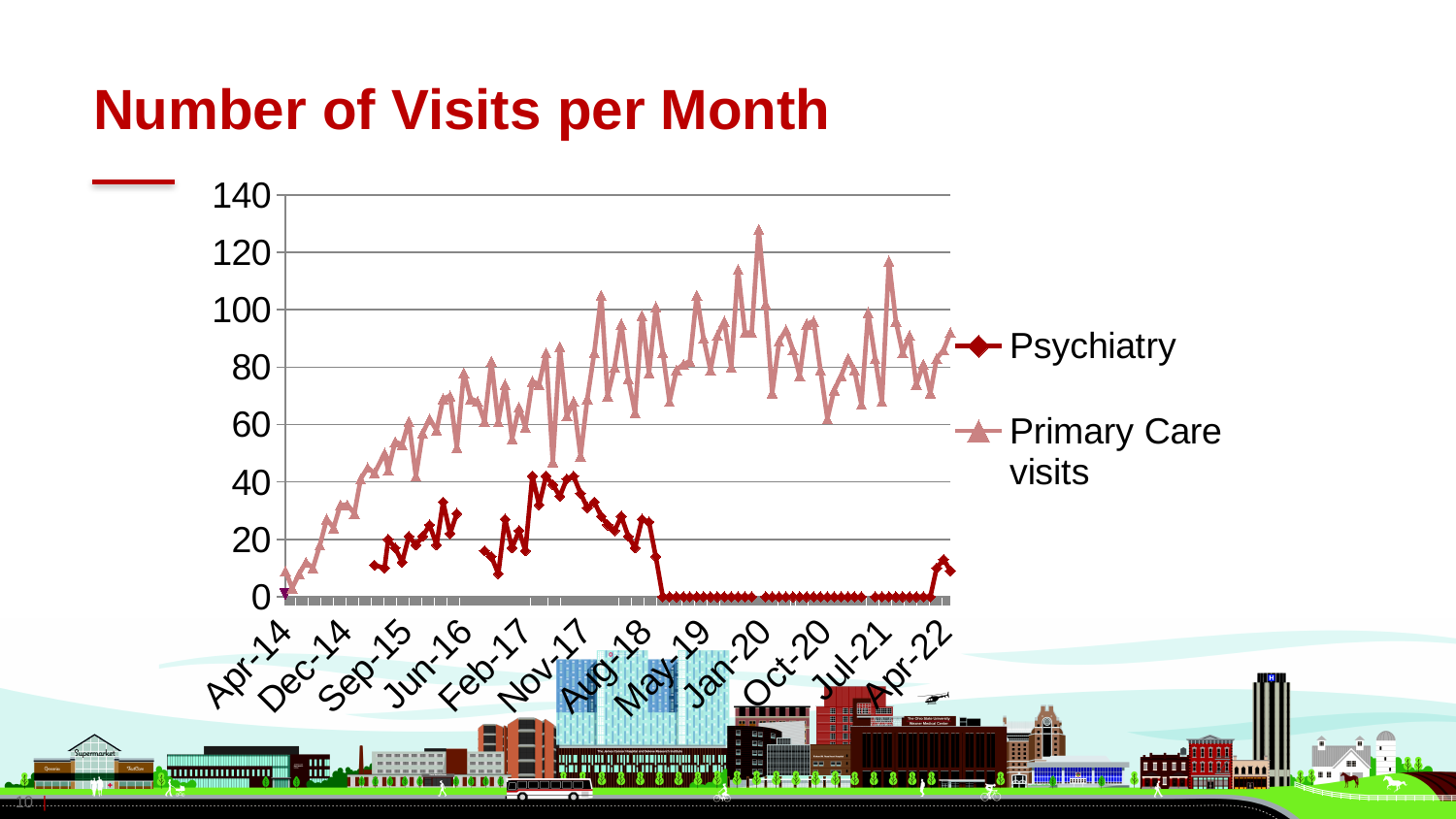
Which series has the larger value at Apr-22, Psychiatry or Primary Care visits? Primary Care visits What is the title of the chart? Number of Visits per Month What kind of chart is shown on the slide? line chart How many series does the legend list? 2 Is the highest value reached by the Psychiatry series greater or less than 60? less Is the highest value reached by the Primary Care visits series greater or less than 120? greater How many month labels are shown along the x axis? 12 Is the Primary Care visits value at Apr-14 greater or less than 20? less What are the two series named in the legend? Psychiatry and Primary Care visits Which series is higher across almost the entire period shown? Primary Care visits Do the Primary Care visits generally rise or fall from Apr-14 to Nov-17? rise